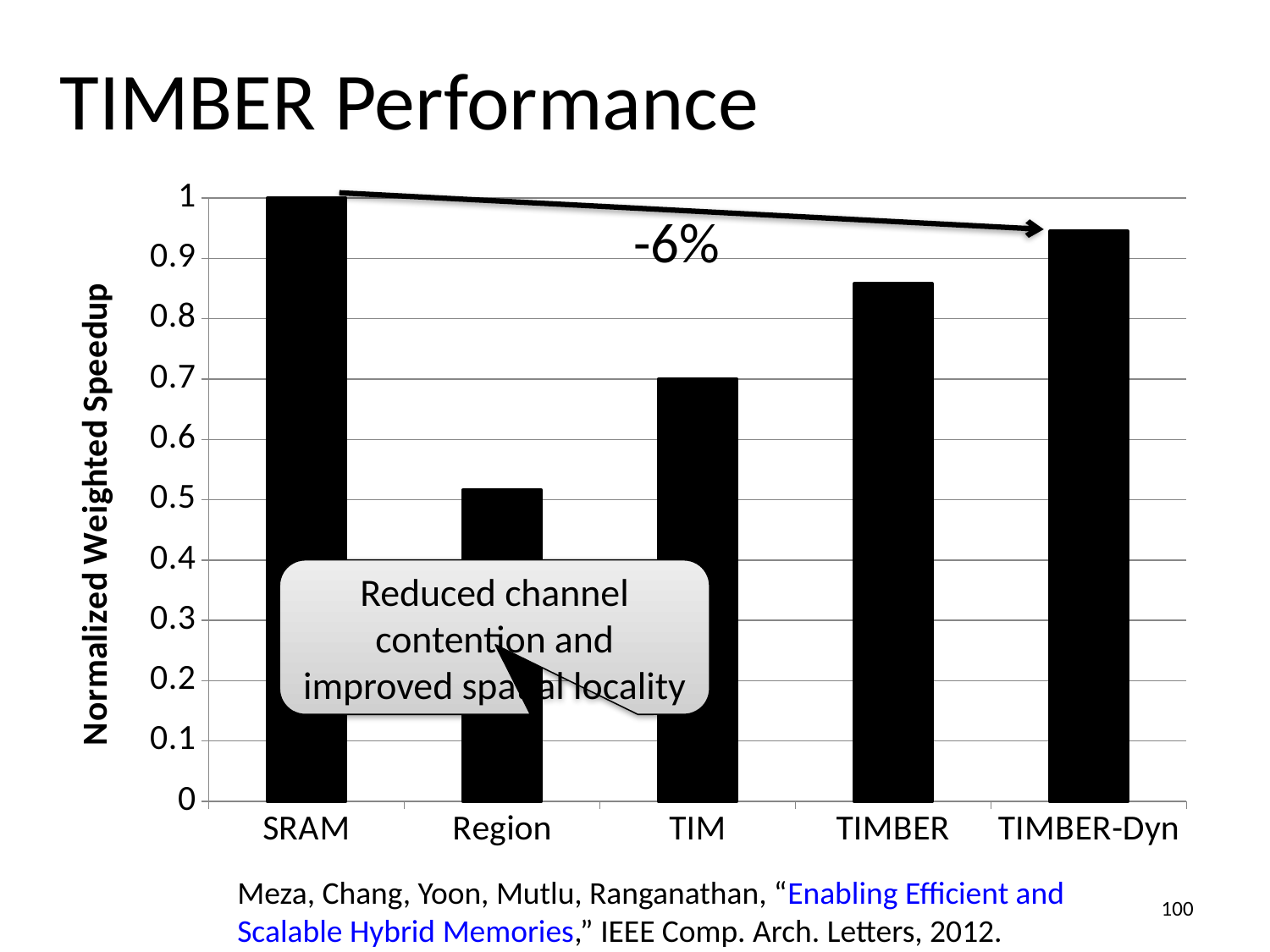
Is the value for TIMBER greater or less than 0.8? greater Which has a higher normalized weighted speedup, Region or TIMBER-Dyn? TIMBER-Dyn How many categories are plotted on the x axis? 5 Which category has the lowest normalized weighted speedup? Region Is the value for TIMBER-Dyn greater or less than 0.9? greater Which has a higher normalized weighted speedup, TIM or TIMBER? TIMBER What percentage change is annotated by the arrow from SRAM to TIMBER-Dyn? -6% What is the label on the y axis? Normalized Weighted Speedup Which category has the highest normalized weighted speedup? SRAM What is the normalized weighted speedup for SRAM? 1 What kind of chart is shown on the slide? bar chart Is the value for Region greater or less than 0.6? less